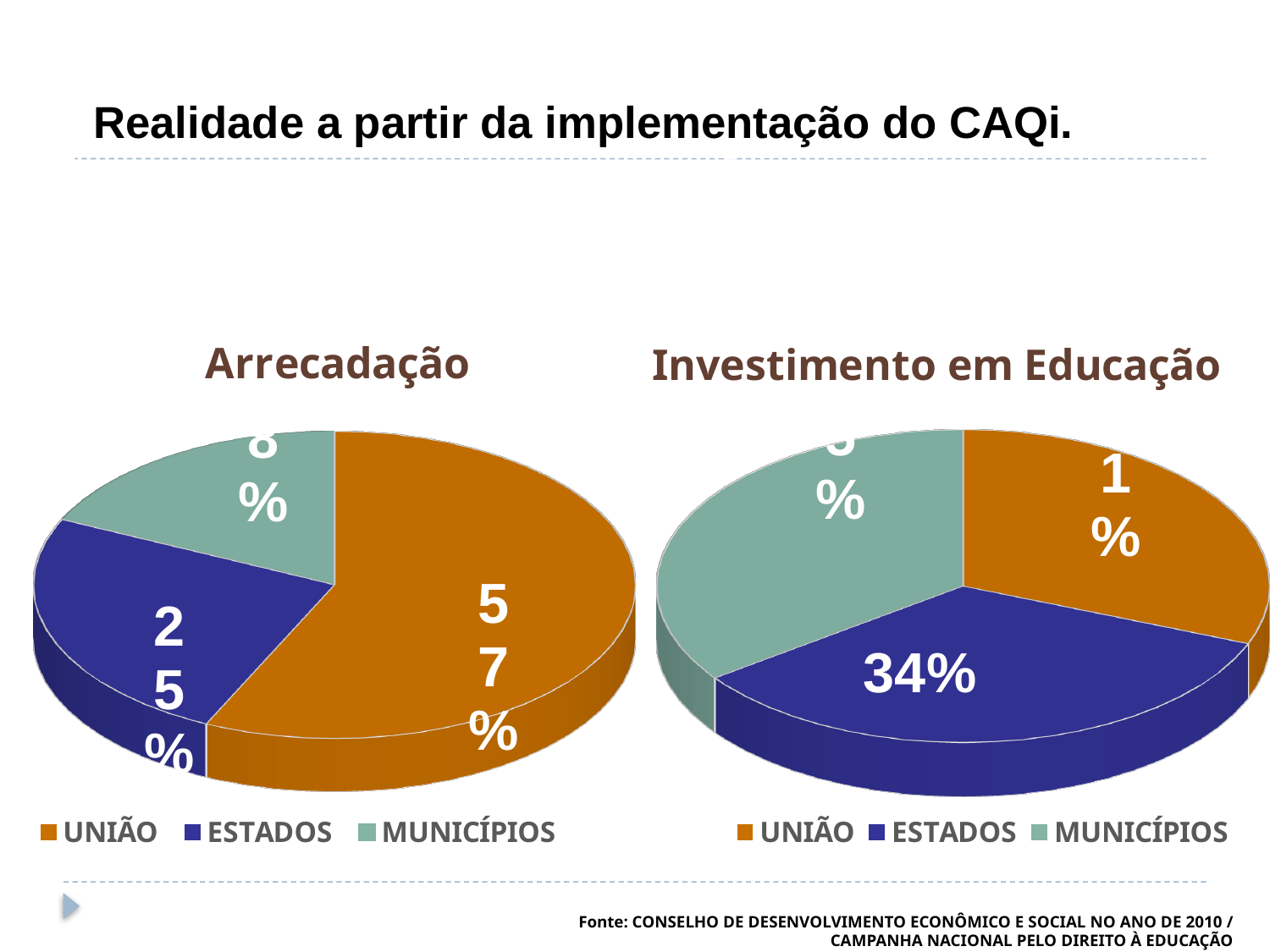
In the Arrecadação pie chart, what is the difference between the UNIÃO share and the ESTADOS share? 32 percentage points In the Investimento em Educação pie chart, what share does ESTADOS have? 34% In the Arrecadação pie chart, what share does ESTADOS have? 25% In the Arrecadação pie chart, what share does UNIÃO have? 57% How many categories does the Arrecadação pie chart show? 3 What are the legend entries of the Investimento em Educação chart? UNIÃO, ESTADOS, MUNICÍPIOS What type of chart is the Investimento em Educação chart? Pie chart In the Arrecadação pie chart, which category has the largest slice? UNIÃO In the Arrecadação pie chart, which category has the smallest slice? MUNICÍPIOS